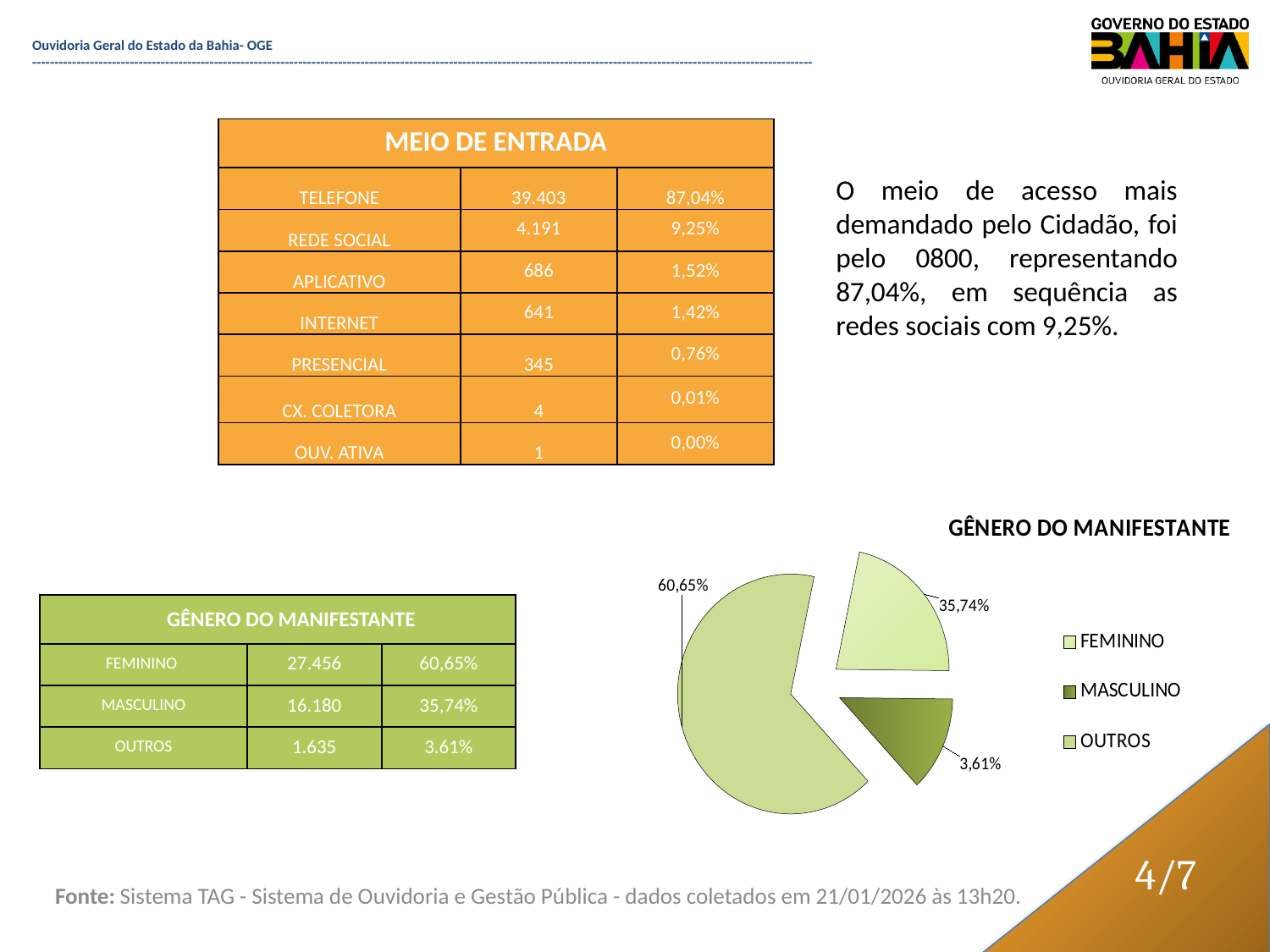
How many slices does the pie chart have? 3 In the pie chart, what is the difference in percentage points between the MASCULINO and OUTROS shares? 32,13 In the pie chart, what percentage is shown for MASCULINO? 35,74% What is the title of the pie chart? GÊNERO DO MANIFESTANTE How many entries does the pie chart's legend list? 3 In the pie chart, what percentage is shown for FEMININO? 60,65% In the pie chart, what is the difference in percentage points between the FEMININO and MASCULINO shares? 24,91 In the pie chart, what percentage is shown for OUTROS? 3,61% Which slice of the pie chart is the smallest? OUTROS In the pie chart, which is larger: the share for MASCULINO or the share for OUTROS? MASCULINO What kind of chart is shown on the slide? pie chart Which slice of the pie chart is the largest? FEMININO